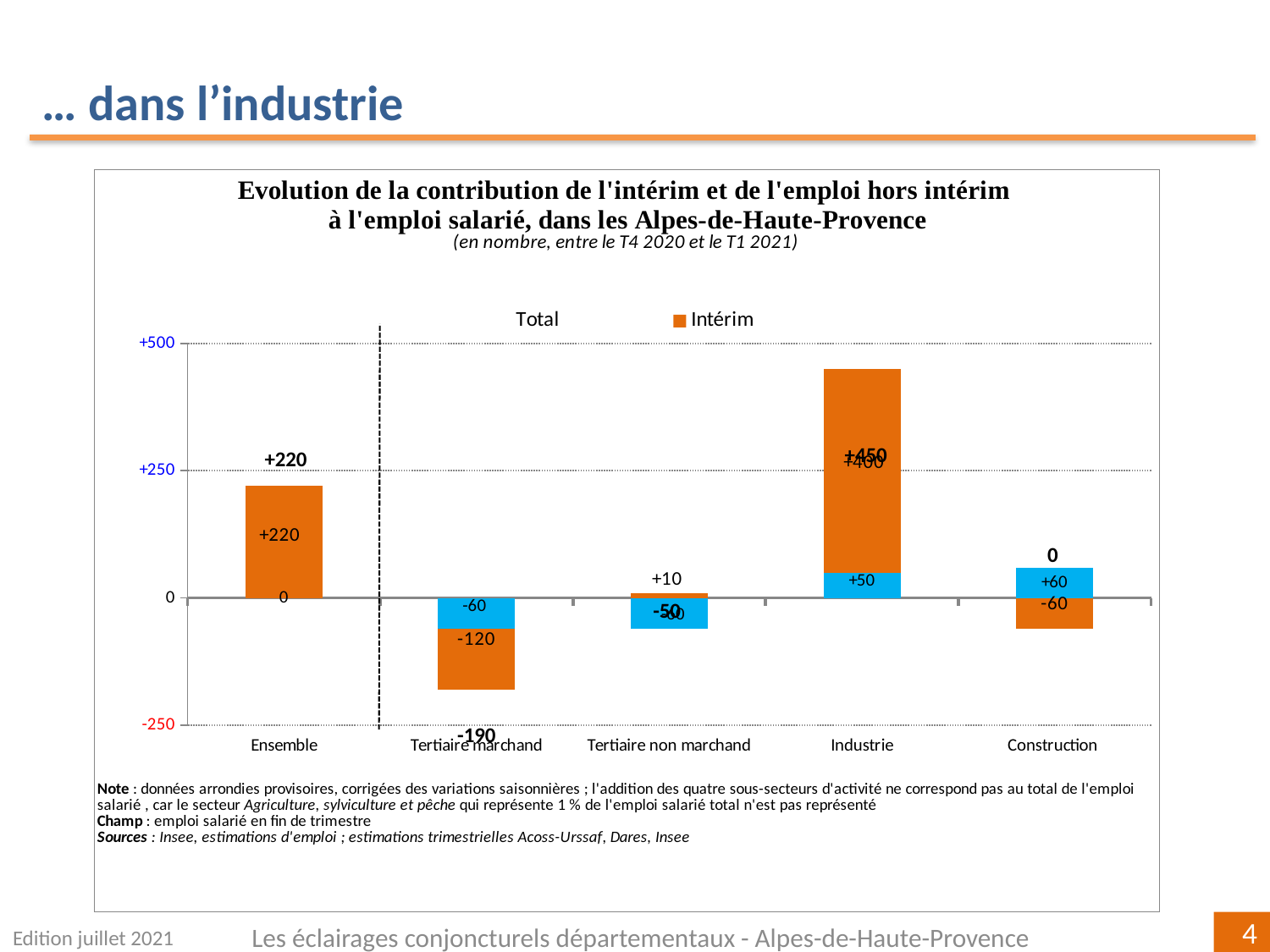
What is the value of the blue segment for Construction? +60 What is the value of the orange segment for Tertiaire marchand? -120 What is the total value labelled for Industrie? +450 What is the total value labelled for Construction? 0 Which is larger, the total for Industrie or the total for Ensemble? Industrie What is the total value labelled for Tertiaire marchand? -190 How many sector categories are shown on the x axis? 5 What kind of chart is shown on the slide? bar chart Which category has the lowest total value? Tertiaire marchand Which category has the highest total value? Industrie What is the total value labelled for Ensemble? +220 What is the difference between the total for Industrie and the total for Ensemble? 230